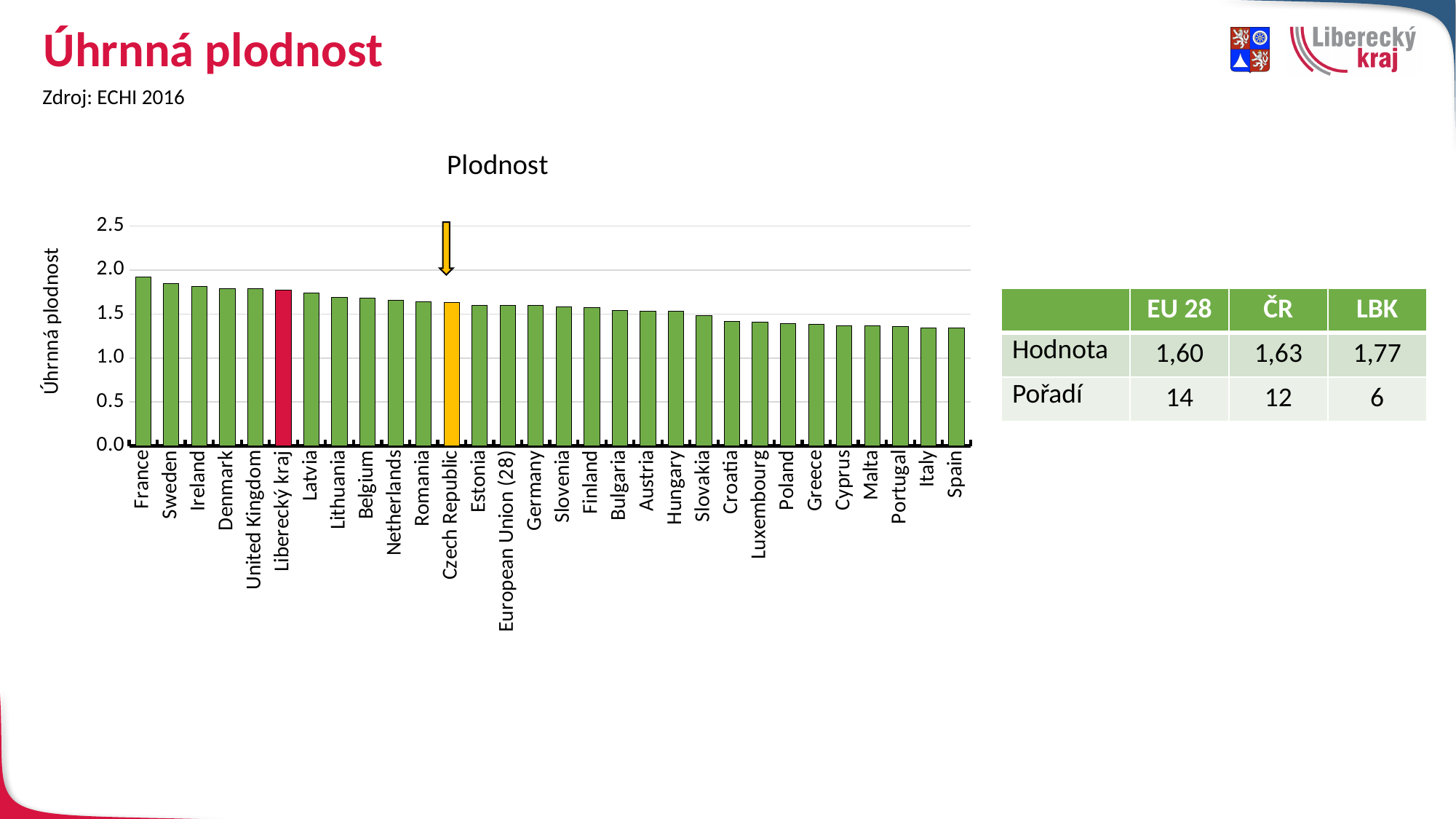
What kind of chart is shown on the slide? bar chart Do the values rise or fall moving from left to right along the x axis? fall Is the value for Poland greater or less than 1.5? less Which has the larger value, Denmark or Poland? Denmark How many countries/regions are plotted on the x axis of the chart? 30 Is the value for France greater or less than 1.5? greater Is the value for Spain greater or less than 1.5? less Which category has the highest bar in the chart? France According to the table next to the chart, what is the value (Hodnota) for EU 28? 1,60 What is the title of the chart? Plodnost Which bar in the chart is coloured red? Liberecký kraj According to the table next to the chart, what is the value (Hodnota) for LBK (Liberecký kraj)? 1,77